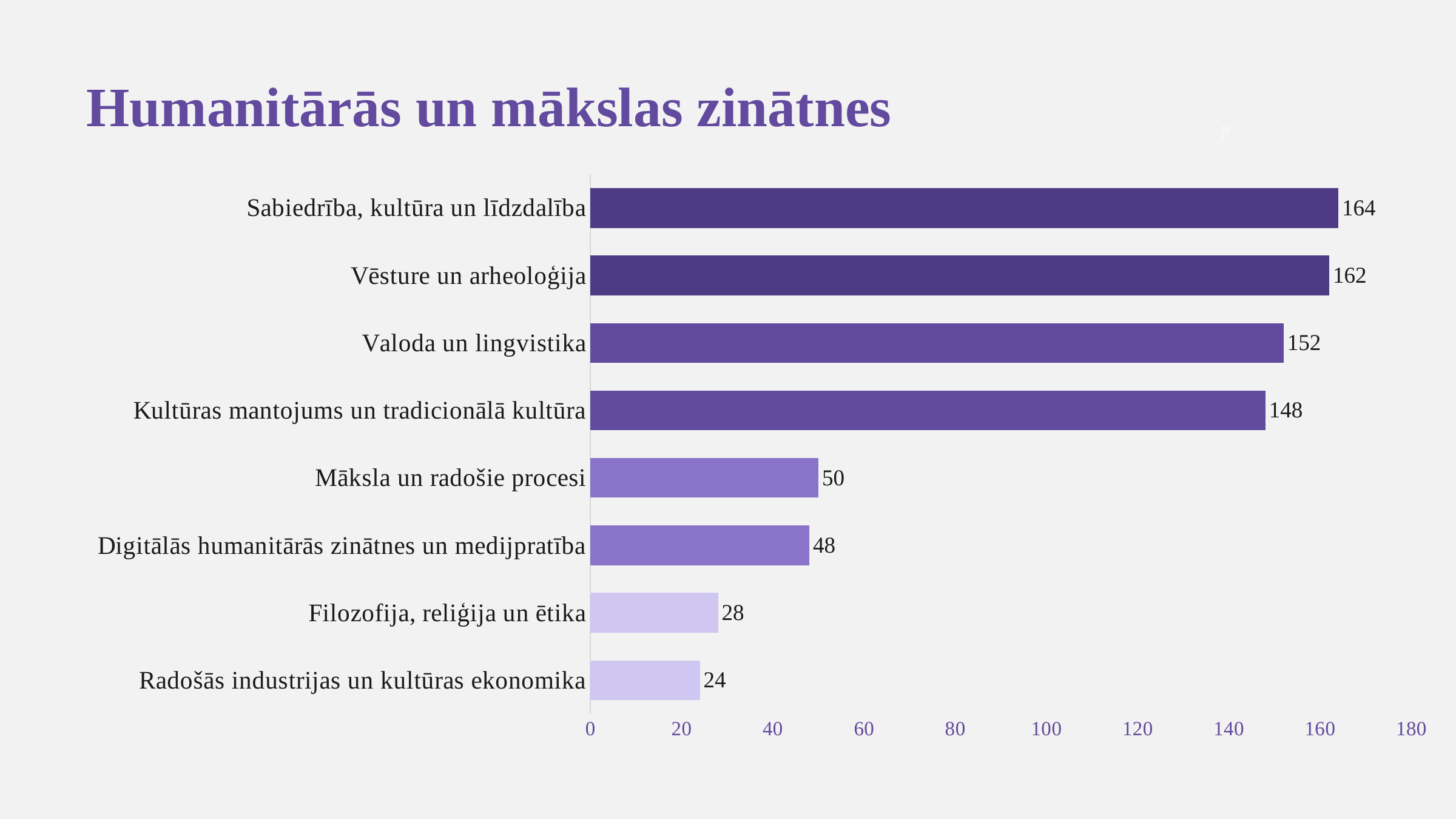
What is the value for Sabiedrība, kultūra un līdzdalība? 164 Is the value for Valoda un lingvistika greater or less than 140? greater Which is larger, the value for Digitālās humanitārās zinātnes un medijpratība or the value for Filozofija, reliģija un ētika? Digitālās humanitārās zinātnes un medijpratība Which category has the lowest value? Radošās industrijas un kultūras ekonomika What is the value for Kultūras mantojums un tradicionālā kultūra? 148 What kind of chart is shown on the slide? bar chart What is the difference between the values for Vēsture un arheoloģija and Valoda un lingvistika? 10 How many categories are shown in the chart? 8 What is the difference between the values for Māksla un radošie procesi and Radošās industrijas un kultūras ekonomika? 26 What is the value for Filozofija, reliģija un ētika? 28 What is the title of the slide? Humanitārās un mākslas zinātnes Which category has the highest value? Sabiedrība, kultūra un līdzdalība